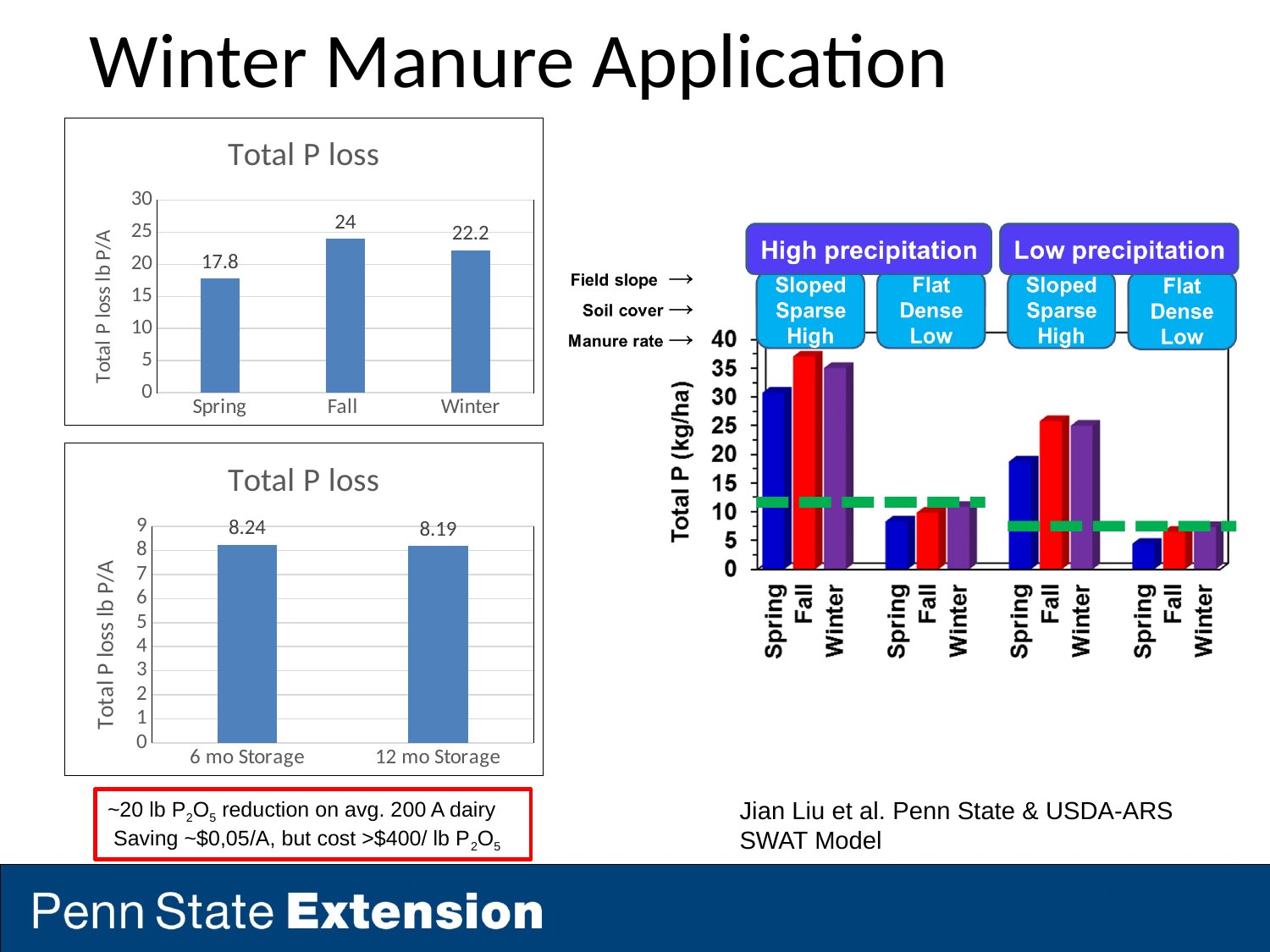
What is the y-axis label of the right-hand chart? Total P (kg/ha) In the top-left chart titled 'Total P loss', what is the value for Fall? 24 In the top-left chart titled 'Total P loss', which season has the lowest total P loss? Spring In the right-hand chart (Total P kg/ha), is the Fall value under High precipitation, Sloped, Sparse, High greater or less than 35? greater In the top-left chart titled 'Total P loss', which season has the highest total P loss? Fall In the bottom-left chart titled 'Total P loss', what is the value for 12 mo Storage? 8.19 In the top-left chart titled 'Total P loss', what is the value for Spring? 17.8 In the bottom-left chart titled 'Total P loss', what is the value for 6 mo Storage? 8.24 In the top-left chart titled 'Total P loss', what is the difference between the Fall and Winter values? 1.8 In the bottom-left chart titled 'Total P loss', how many categories are shown on the x axis? 2 What kind of chart is the top-left 'Total P loss' chart? Bar chart